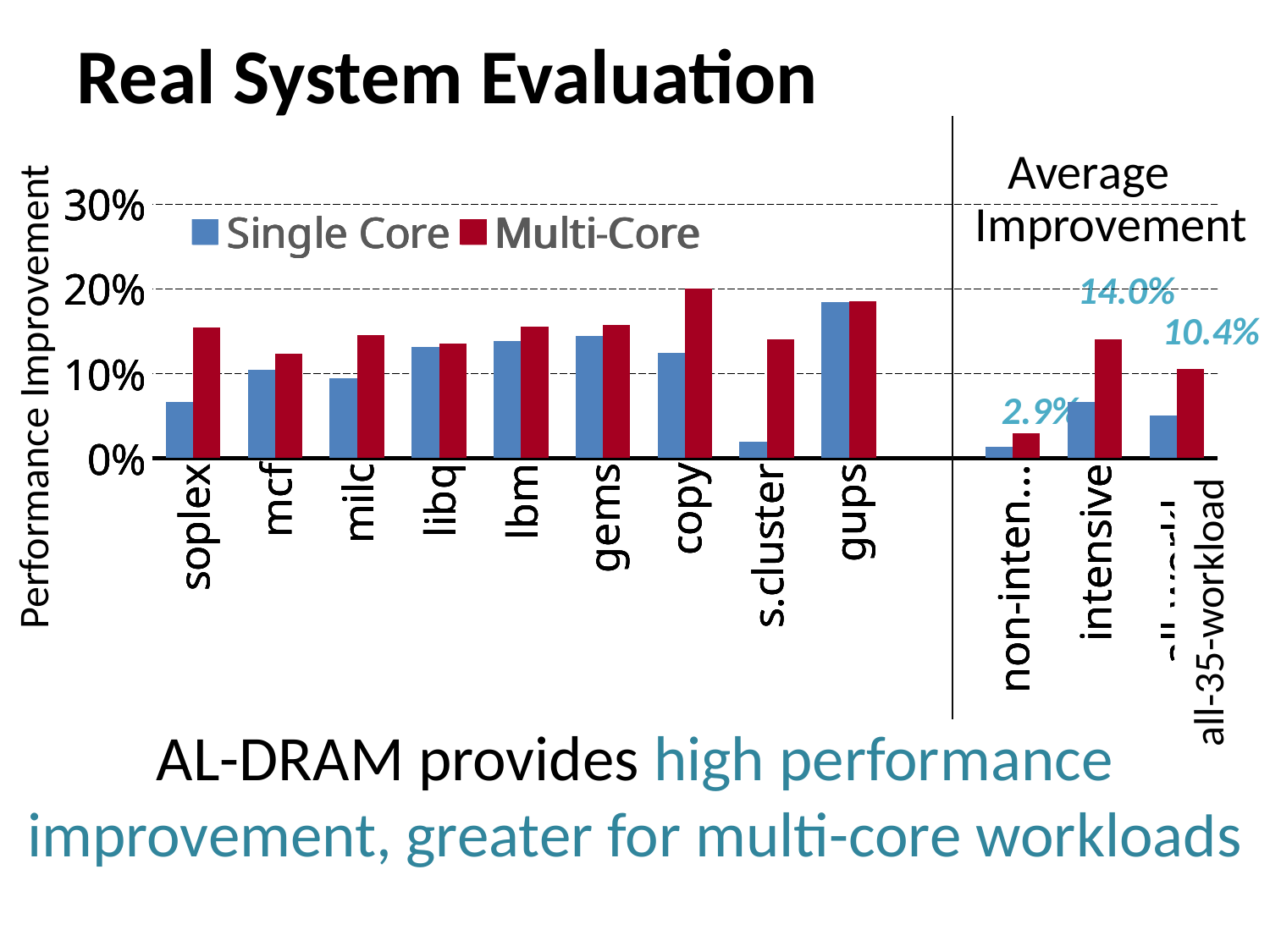
What is the difference between the Multi-Core average improvement for intensive workloads (14.0%) and for all-35-workload (10.4%)? 3.6% How many individual benchmarks are plotted to the left of the vertical divider line? 9 Is the Single Core performance improvement for soplex greater or less than 10%? less What are the two series named in the legend? Single Core and Multi-Core What is the Multi-Core average improvement for all-35-workload? 10.4% Is the Multi-Core performance improvement for copy greater or less than 10%? greater How many series does the legend list? 2 Among the nine individual benchmarks left of the divider, which has the highest Multi-Core performance improvement? copy What kind of chart is shown on the slide? bar chart For copy, which is larger: the Single Core or the Multi-Core performance improvement? Multi-Core What is the Multi-Core average improvement for the intensive workloads? 14.0% Among the nine individual benchmarks left of the divider, which has the lowest Single Core performance improvement? s.cluster